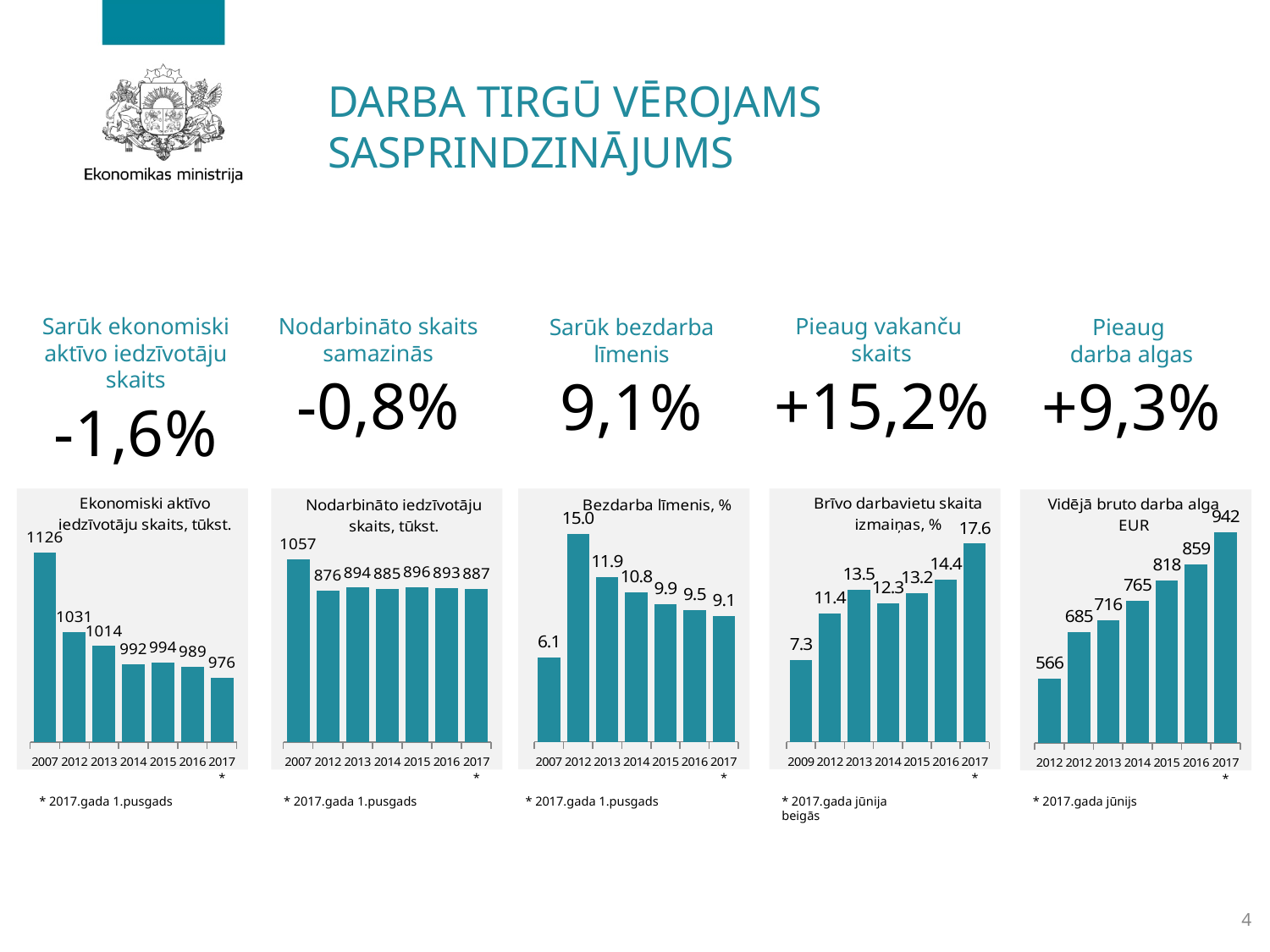
In the chart titled "Brīvo darbavietu skaita izmaiņas, %", how many bars are plotted? 7 In the chart titled "Nodarbināto iedzīvotāju skaits, tūkst.", what is the value for 2015? 896 In the chart titled "Vidējā bruto darba alga EUR", do the values generally rise or fall from left to right? rise In the chart titled "Bezdarba līmenis, %", is the value for 2013 larger or smaller than the value for 2014? larger In the chart titled "Ekonomiski aktīvo iedzīvotāju skaits, tūkst.", what is the value for 2007? 1126 In the chart titled "Brīvo darbavietu skaita izmaiņas, %", what is the value for 2017? 17.6 In the chart titled "Vidējā bruto darba alga EUR", what is the value for 2016? 859 What kind of chart is the chart titled "Vidējā bruto darba alga EUR"? bar chart In the chart titled "Nodarbināto iedzīvotāju skaits, tūkst.", what is the difference between the 2007 value and the 2012 value? 181 In the chart titled "Bezdarba līmenis, %", which year has the highest value? 2012 In the chart titled "Ekonomiski aktīvo iedzīvotāju skaits, tūkst.", which year has the lowest value? 2017 In the chart titled "Bezdarba līmenis, %", what is the value for 2017? 9.1